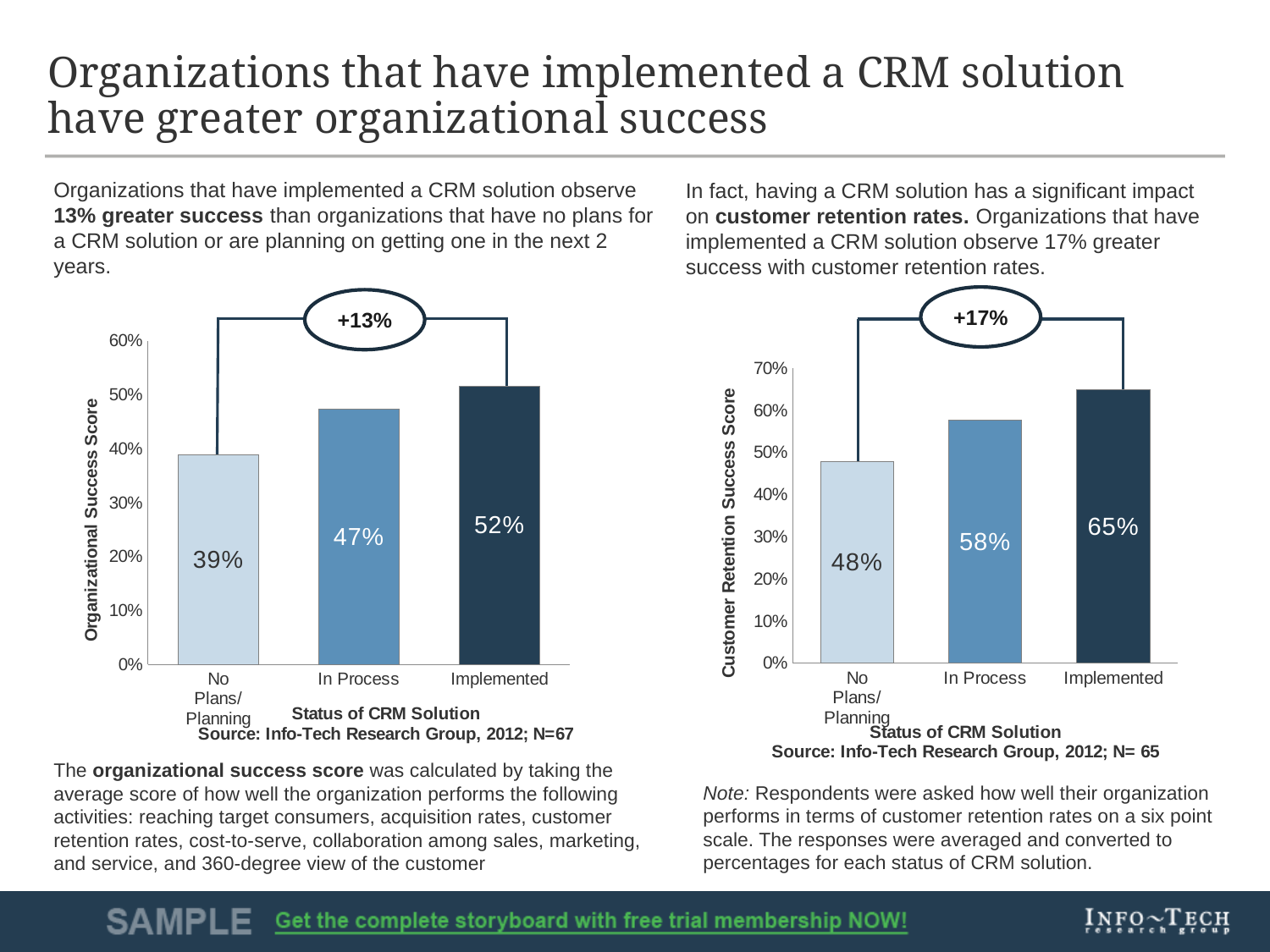
In the right chart (Customer Retention Success Score), do the values rise or fall from No Plans/Planning to Implemented? rise In the right chart (Customer Retention Success Score), which category has the highest value? Implemented In the left chart (Organizational Success Score), what is the value for No Plans/Planning? 39% How many categories are shown on the x axis of the left chart (Organizational Success Score)? 3 In the right chart (Customer Retention Success Score), is the value for No Plans/Planning greater or less than 50%? less In the right chart (Customer Retention Success Score), what is the value for In Process? 58% What kind of chart is the right chart (Customer Retention Success Score)? bar chart In the left chart (Organizational Success Score), what is the value for Implemented? 52% In the left chart (Organizational Success Score), which is larger: In Process or Implemented? Implemented In the right chart (Customer Retention Success Score), what is the difference between Implemented and No Plans/Planning? 17% In the left chart (Organizational Success Score), what is the difference between In Process and No Plans/Planning? 8% In the left chart (Organizational Success Score), which category has the lowest value? No Plans/Planning